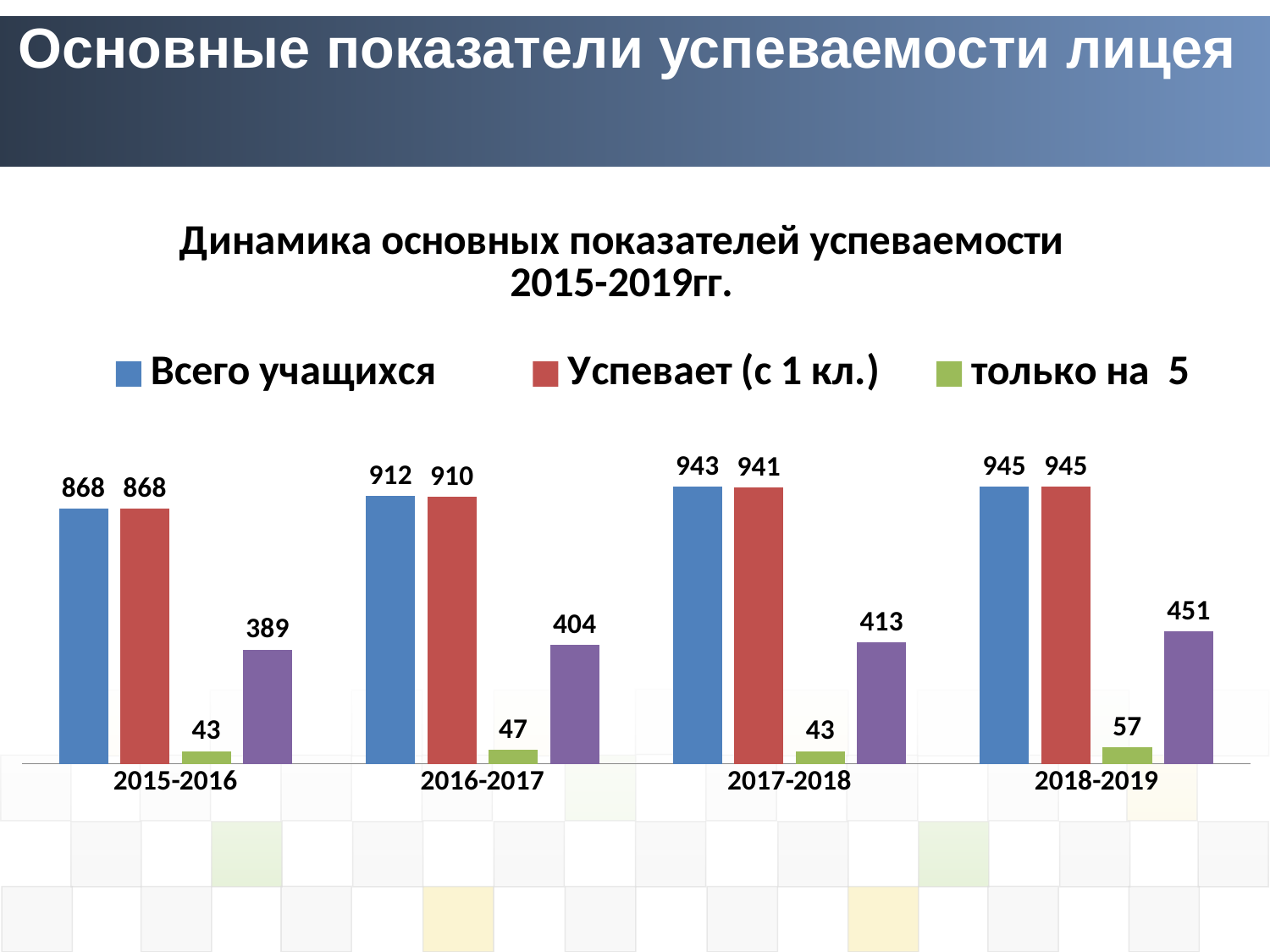
What is the difference between Всего учащихся and Успевает (с 1 кл.) in 2016-2017? 2 What is the value of Успевает (с 1 кл.) for 2017-2018? 941 What is the value of только на 5 for 2018-2019? 57 How many school years are shown on the x axis? 4 In which school year is только на 5 the highest? 2018-2019 Which is larger: только на 5 in 2016-2017 or in 2015-2016? 2016-2017 What kind of chart is shown on the slide? bar chart In which school year is Всего учащихся the lowest? 2015-2016 In which school year is Всего учащихся the highest? 2018-2019 How many series does the legend list? 3 What is the difference between Всего учащихся in 2018-2019 and in 2015-2016? 77 What is the value of Всего учащихся for 2016-2017? 912